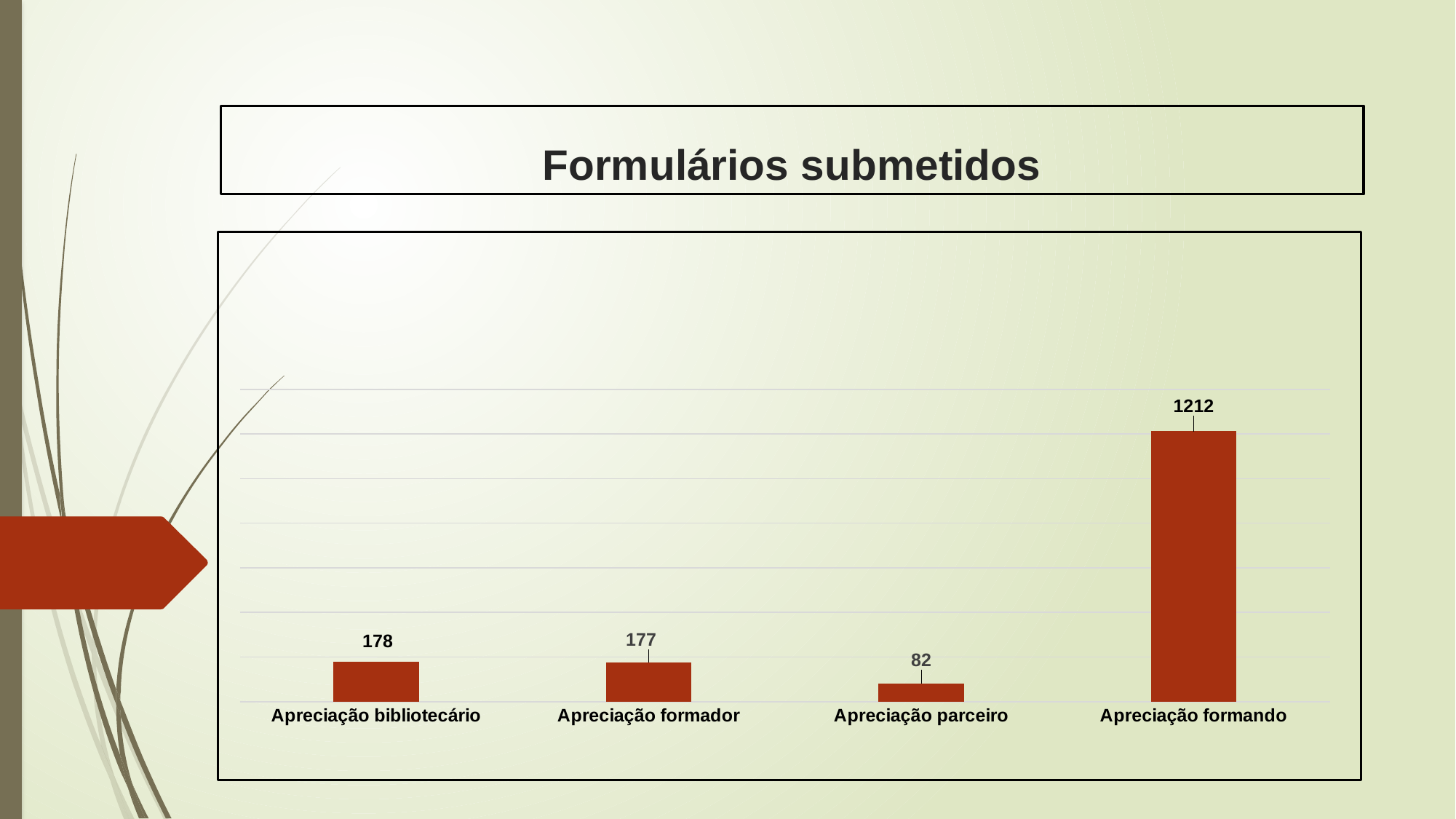
What is the difference between the values for Apreciação bibliotecário and Apreciação parceiro? 96 What is the value for Apreciação parceiro? 82 What is the value for Apreciação formando? 1212 Which category has the highest value? Apreciação formando Which category has the lowest value? Apreciação parceiro What kind of chart is shown on the slide? Bar chart What is the value for Apreciação bibliotecário? 178 What is the value for Apreciação formador? 177 What is the difference between the values for Apreciação formando and Apreciação bibliotecário? 1034 How many categories are shown in the chart? 4 What is the title of the chart? Formulários submetidos Which is larger, the value for Apreciação formador or Apreciação parceiro? Apreciação formador